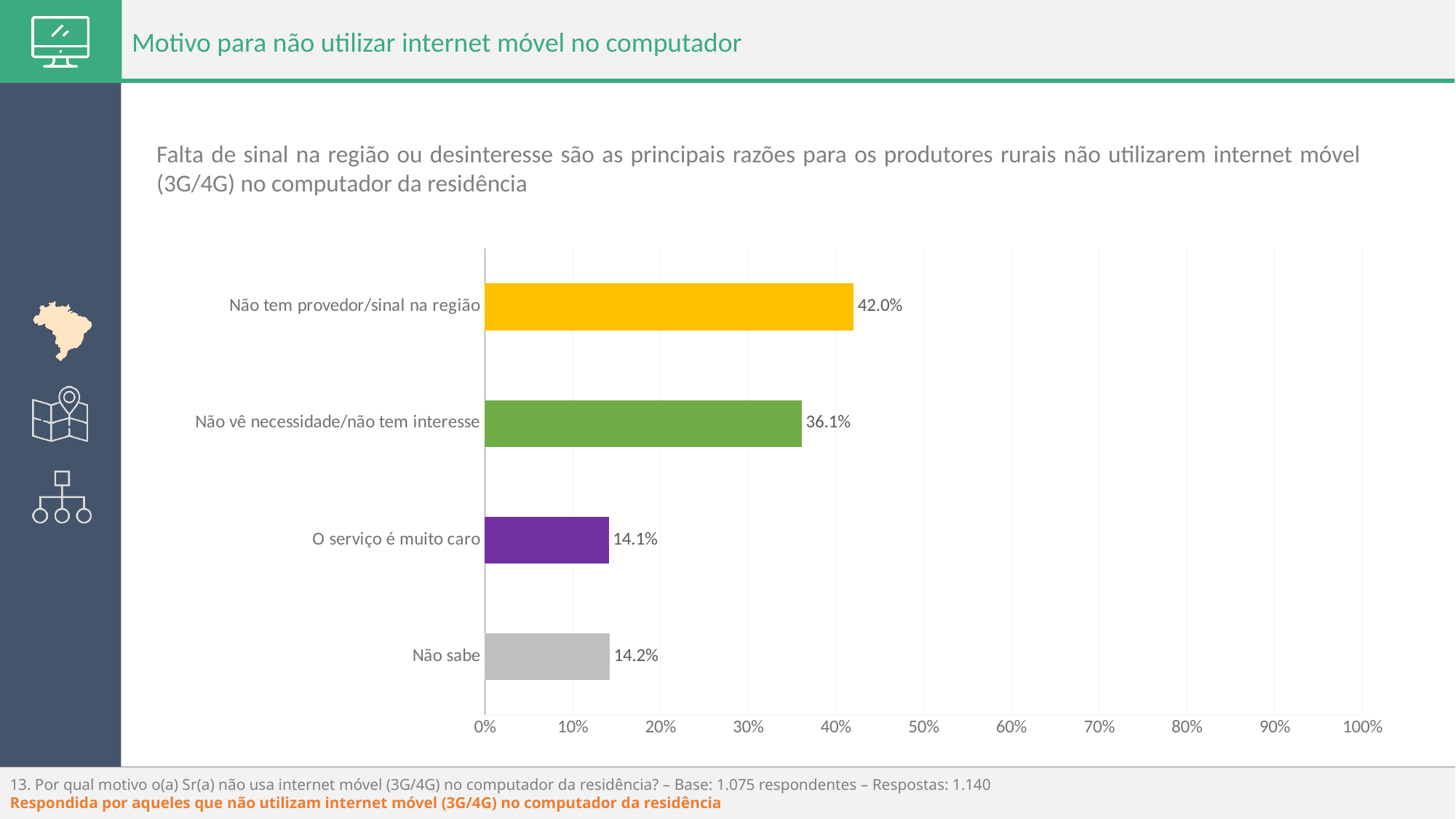
What is the title of the slide? Motivo para não utilizar internet móvel no computador What is the value for "Não sabe"? 14.2% What is the value for "O serviço é muito caro"? 14.1% What kind of chart is shown on the slide? bar chart What is the value for "Não vê necessidade/não tem interesse"? 36.1% How many categories are shown in the chart? 4 Which is larger, the value for "Não tem provedor/sinal na região" or the value for "O serviço é muito caro"? Não tem provedor/sinal na região Which category has the highest value? Não tem provedor/sinal na região What is the value for "Não tem provedor/sinal na região"? 42.0% Is the value for "Não vê necessidade/não tem interesse" greater or less than 40%? less What is the difference between "Não vê necessidade/não tem interesse" and "Não sabe"? 21.9 percentage points What is the difference between "Não tem provedor/sinal na região" and "Não vê necessidade/não tem interesse"? 5.9 percentage points